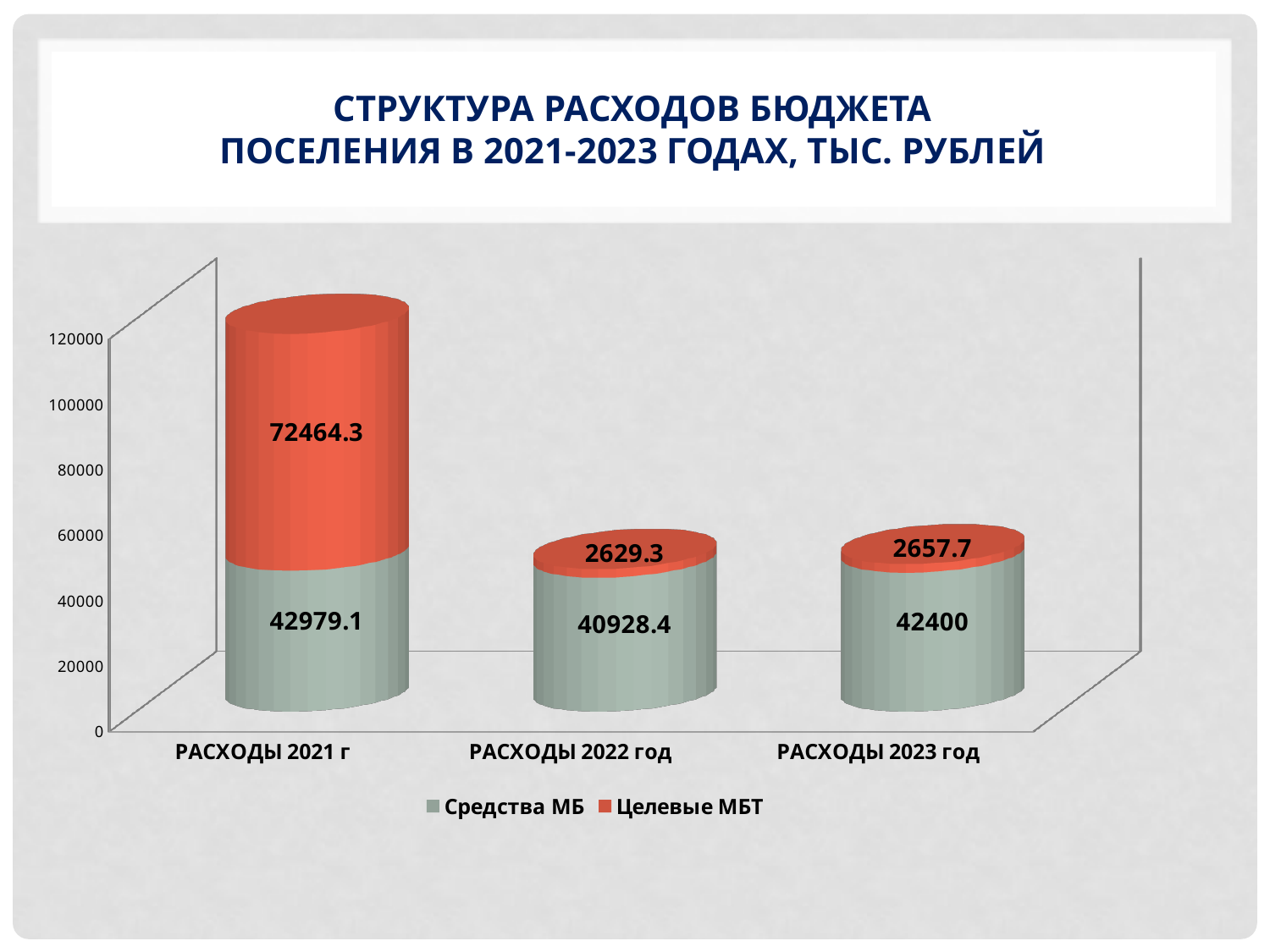
What is the total of the stacked bar for РАСХОДЫ 2022 год? 43557.7 What is the value of Средства МБ for РАСХОДЫ 2021 г? 42979.1 Which category has the highest value for Целевые МБТ? РАСХОДЫ 2021 г How many series does the legend list? 2 What is the value of Целевые МБТ for РАСХОДЫ 2021 г? 72464.3 What is the difference between Целевые МБТ for РАСХОДЫ 2021 г and РАСХОДЫ 2022 год? 69835 What kind of chart is shown on the slide? Stacked bar chart Which category has the lowest value for Средства МБ? РАСХОДЫ 2022 год What is the value of Средства МБ for РАСХОДЫ 2023 год? 42400 What is the value of Целевые МБТ for РАСХОДЫ 2022 год? 2629.3 How many categories are shown on the x axis? 3 Which is larger: Средства МБ for РАСХОДЫ 2021 г or for РАСХОДЫ 2023 год? РАСХОДЫ 2021 г